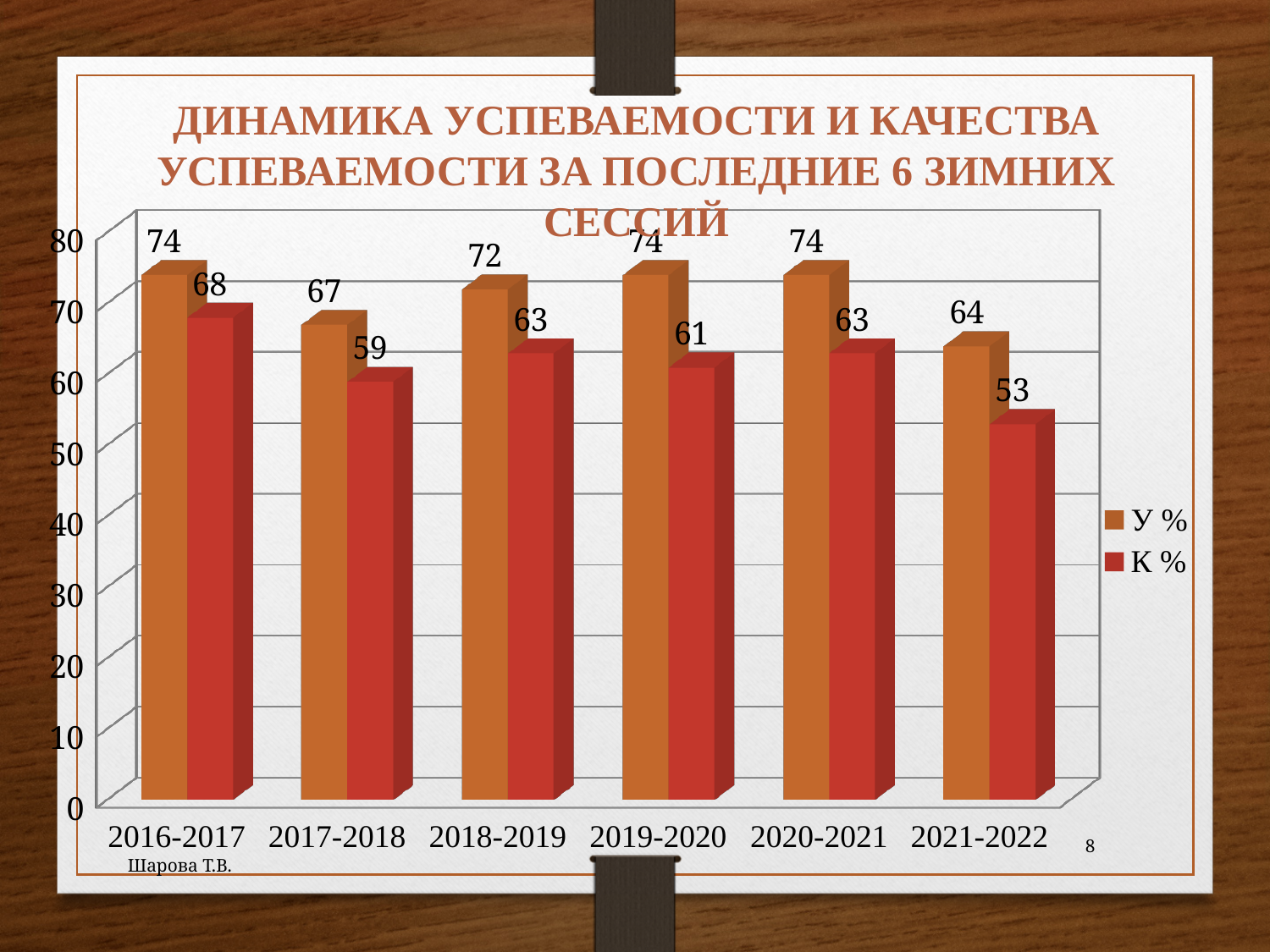
What kind of chart is shown on the slide? Bar chart Which session has the highest К % value? 2016-2017 What is the difference between the К % values for 2016-2017 and 2017-2018? 9 Which is larger: the У % value for 2017-2018 or the У % value for 2018-2019? 2018-2019 What is the difference between У % and К % for 2021-2022? 11 How many sessions (categories) are shown on the x axis? 6 Which session has the lowest У % value? 2021-2022 What is the value of К % for 2017-2018? 59 Which session has the lowest К % value? 2021-2022 What is the value of К % for 2019-2020? 61 What is the value of У % for 2018-2019? 72 How many series does the legend list? 2